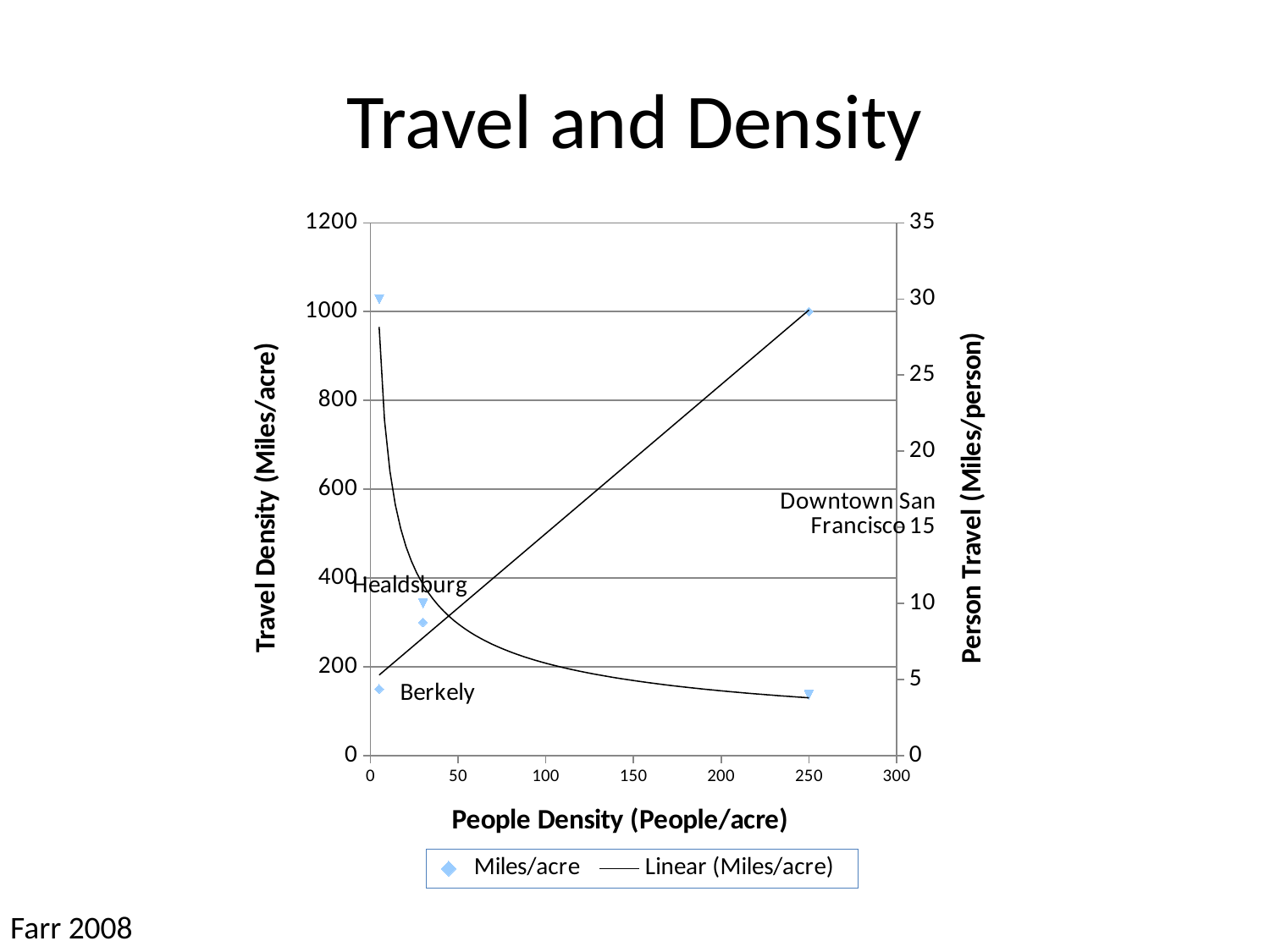
Is the People Density (People/acre) value for Downtown San Francisco greater or less than 200? greater Which labelled city has the lowest Travel Density (Miles/acre)? Berkely How many labelled city data points are plotted for the Miles/acre series? 3 What is the title of the x axis? People Density (People/acre) What is the title of the chart on the slide? Travel and Density Which has a higher Travel Density (Miles/acre), Healdsburg or Berkely? Healdsburg Which labelled city has the highest Travel Density (Miles/acre)? Downtown San Francisco How many series does the legend list? 2 Does Travel Density (Miles/acre) rise or fall as People Density increases along the x axis? rise What kind of chart is shown on the slide? scatter chart Is the Travel Density (Miles/acre) value for Healdsburg greater or less than 400? less Is the Travel Density (Miles/acre) value for Berkely greater or less than 200? less